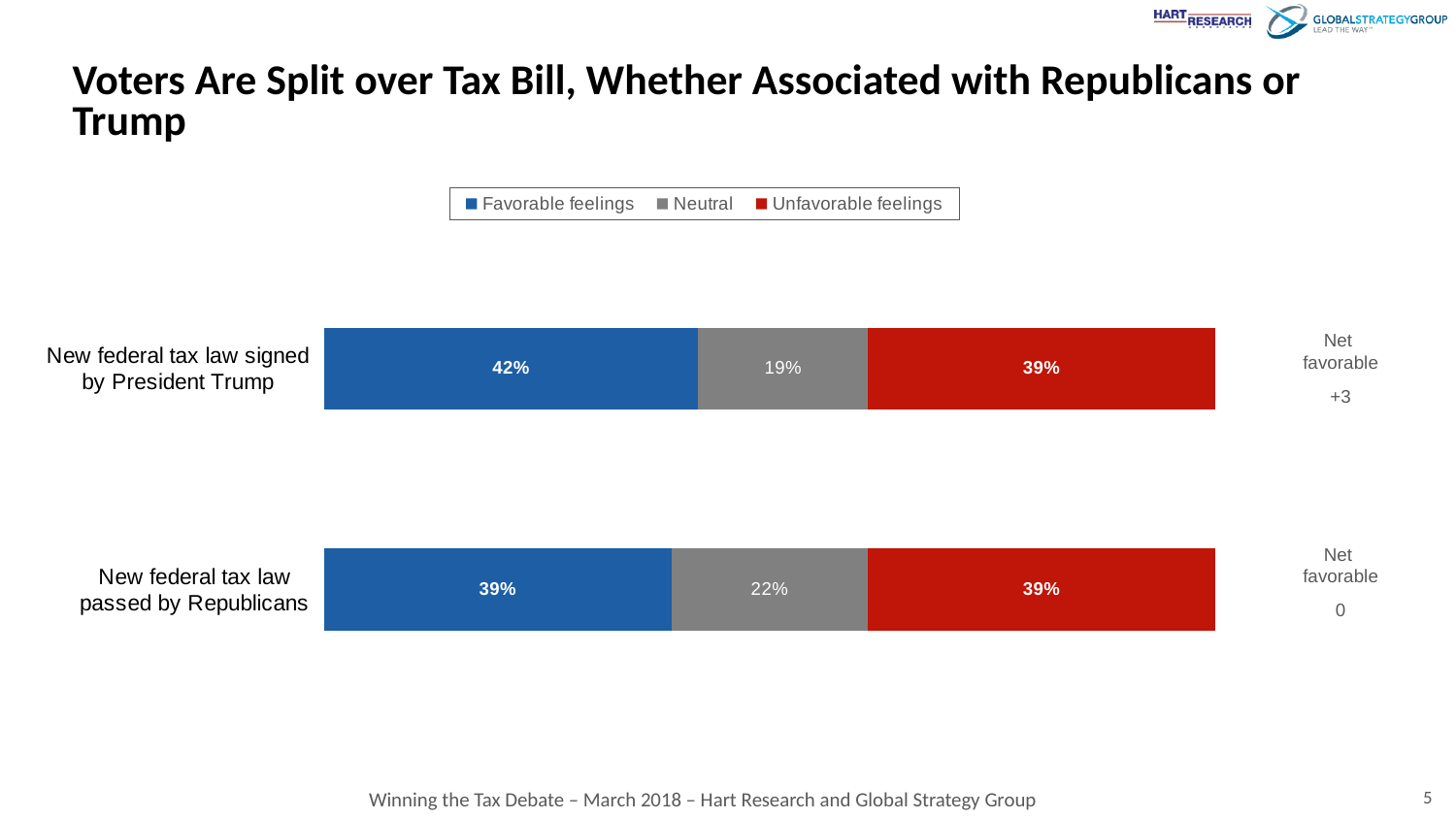
What is the total of the three segments in the bar for the new federal tax law signed by President Trump? 100% What percentage of voters are neutral toward the new federal tax law passed by Republicans? 22% What percentage of voters have unfavorable feelings toward the new federal tax law passed by Republicans? 39% What is the difference in the neutral percentage between the tax law passed by Republicans and the tax law signed by President Trump? 3 percentage points Which item has the higher favorable feelings percentage: the tax law signed by President Trump or the tax law passed by Republicans? New federal tax law signed by President Trump How many series does the legend list? 3 What type of chart is shown on the slide? Stacked horizontal bar chart What is the net favorable figure shown for the new federal tax law passed by Republicans? 0 What is the difference between the favorable and unfavorable percentages for the new federal tax law signed by President Trump? 3 percentage points What percentage of voters have favorable feelings toward the new federal tax law signed by President Trump? 42% How many categories (bars) are shown in the chart? 2 What is the net favorable figure shown for the new federal tax law signed by President Trump? +3